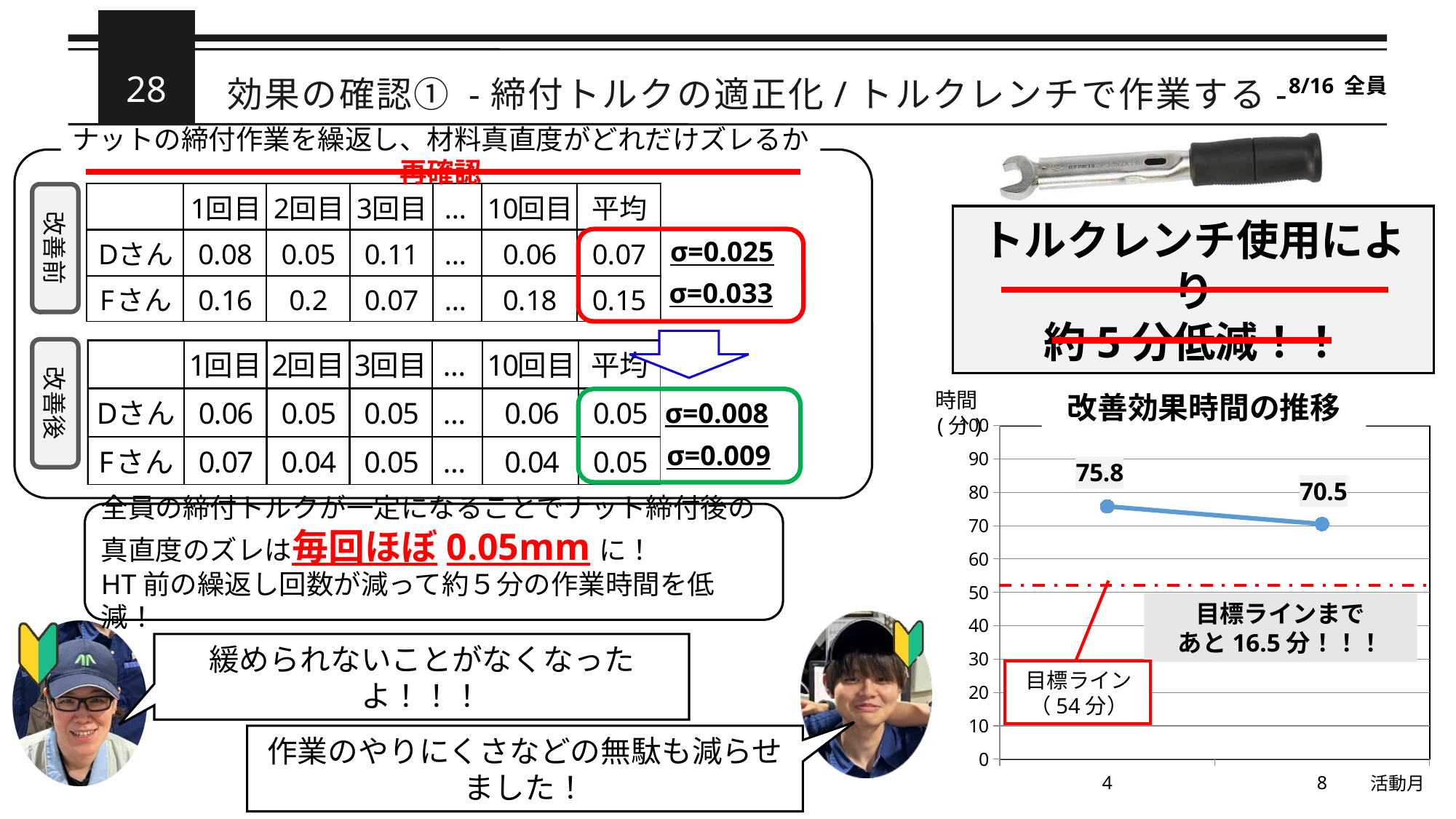
What value does the target line (目標ライン) represent, according to the label on the chart? 54分 Do the plotted values rise or fall from month 4 to month 8? fall How many data points are plotted on the line? 2 What is the unit shown on the vertical axis of the chart? 時間（分） What is the difference between the values for month 4 and month 8? 5.3 What is the value plotted for activity month 8? 70.5 What is the value plotted for activity month 4? 75.8 Is the value for month 8 greater or less than 60? greater Which activity month has the higher value, 4 or 8? 4 What is the title of the chart on the slide? 改善効果時間の推移 Which activity month has the lowest plotted value? 8 What type of chart is shown on the slide? line chart